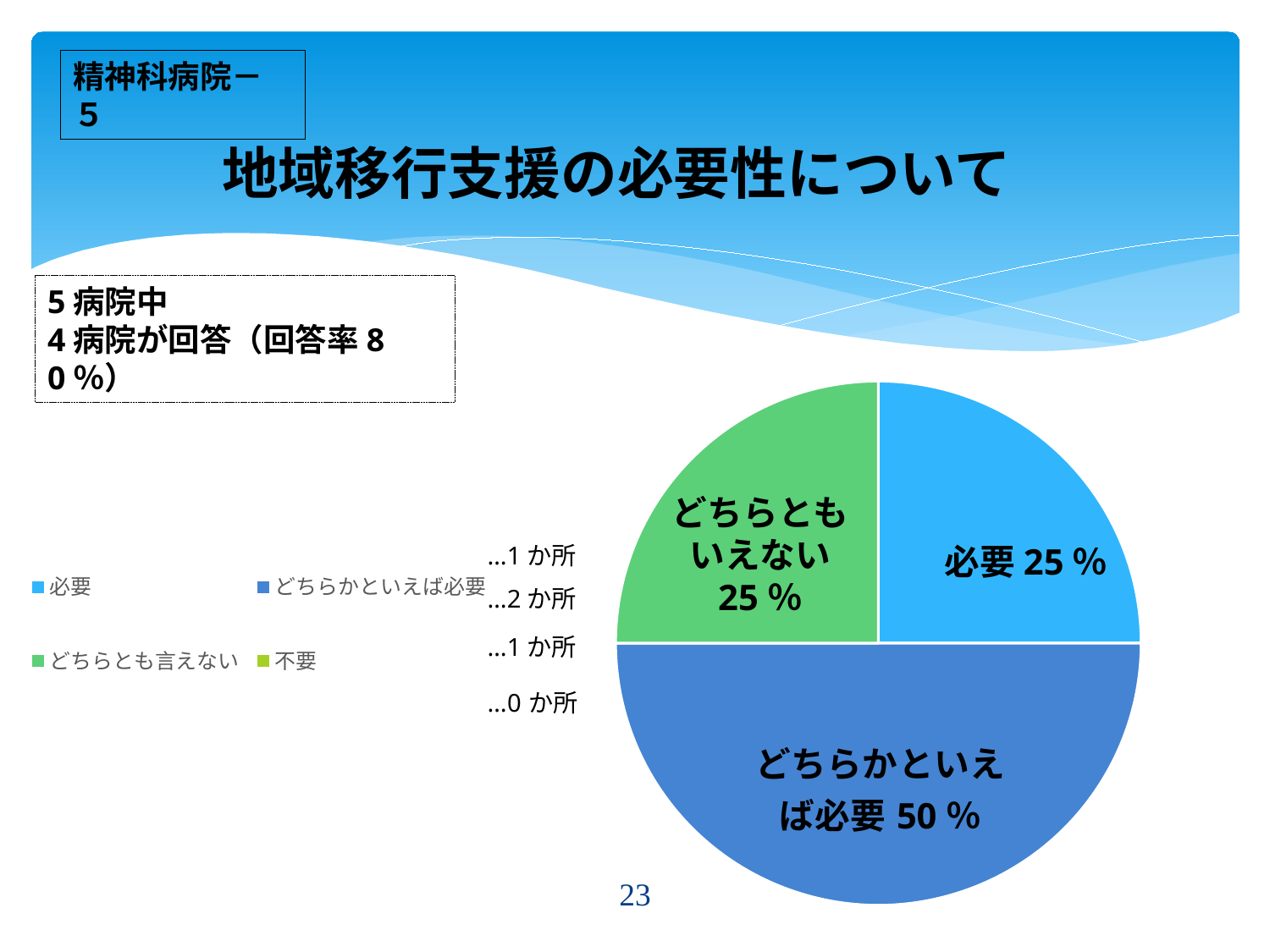
What share of the pie does どちらともいえない represent? 25％ What is the difference in percentage points between the どちらかといえば必要 slice and the 必要 slice? 25 What kind of chart is shown on the slide? pie chart Which category has the largest slice of the pie? どちらかといえば必要 What share of the pie does 必要 represent? 25％ What is the title of the slide containing the pie chart? 地域移行支援の必要性について How many hospitals (か所) answered 不要? 0 か所 Which is larger, the slice for どちらかといえば必要 or the slice for 必要? どちらかといえば必要 How many hospitals (か所) answered どちらかといえば必要? 2 か所 How many entries does the legend list? 4 How many slices are visible in the pie chart? 3 What share of the pie does どちらかといえば必要 represent? 50％